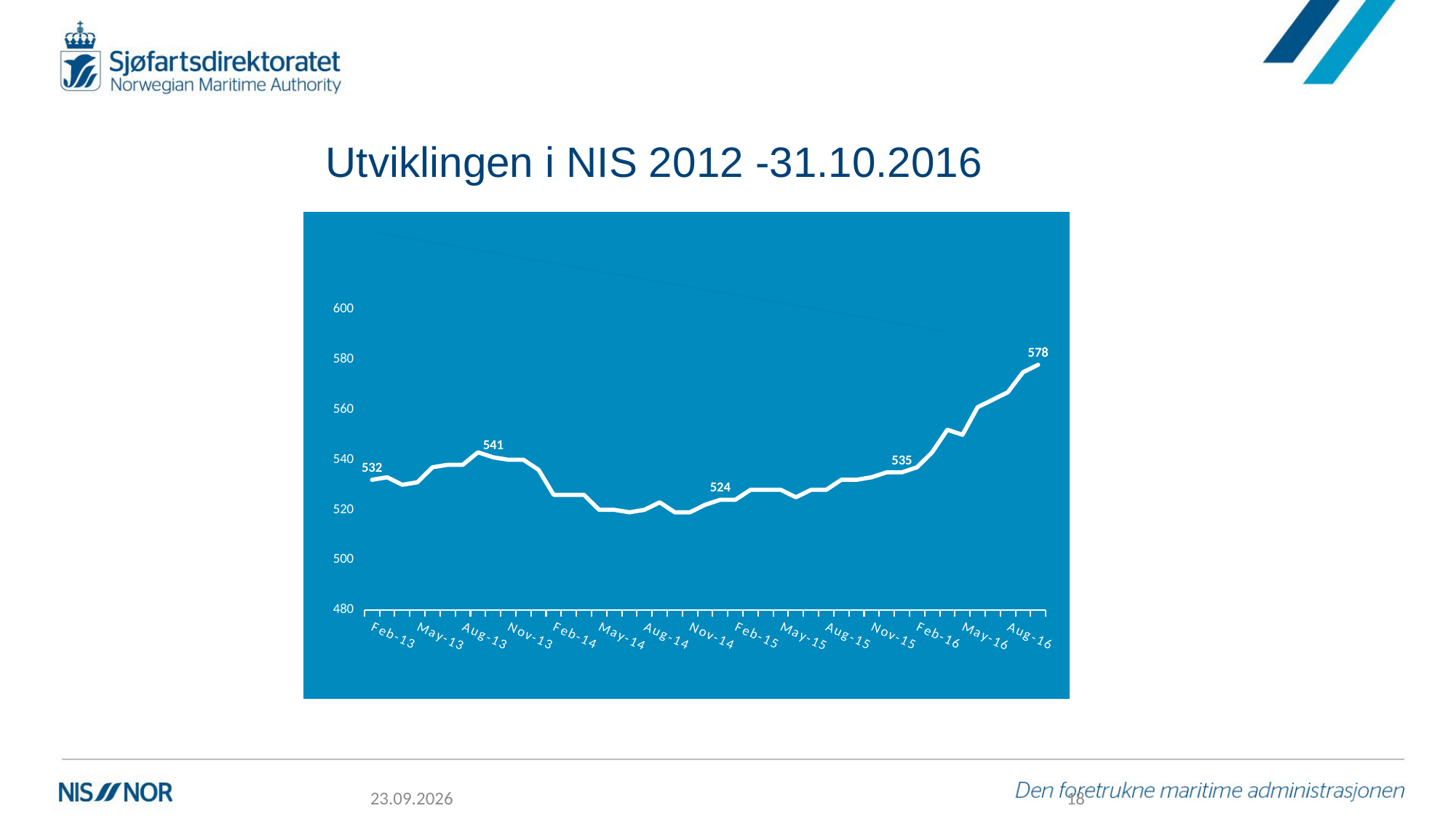
What kind of chart is shown on the slide? line chart What is the lowest data label printed on the chart? 524 Does the line rise or fall between Nov-15 and Aug-16? rise Which is larger, the labelled value 541 near Aug-13 or the labelled value 535 near the start of 2016? 541 What is the title of the slide containing the chart? Utviklingen i NIS 2012 -31.10.2016 What is the difference between the last labelled value (578) and the first labelled value (532)? 46 What is the last data label printed on the line, at the end of the series? 578 Is the value at Feb-14 greater or less than 540? less What is the first data label printed on the line, at the start of the series? 532 What is the highest data label printed on the chart? 578 Is the value at Aug-16 greater or less than 560? greater What is the data label printed at the peak around Aug-13? 541